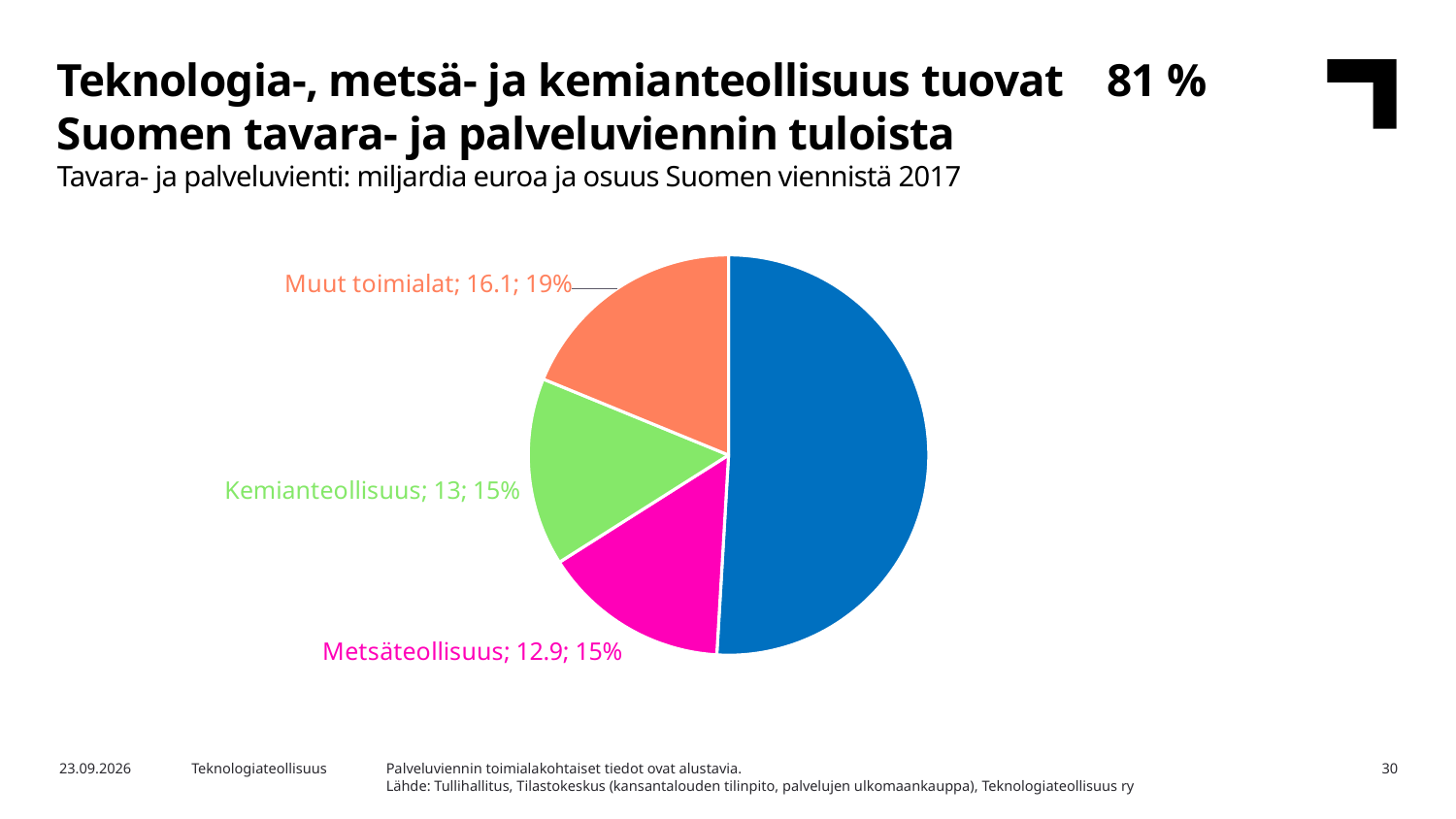
What share of the pie does Metsäteollisuus represent? 15% What value in billions of euros is shown for Kemianteollisuus? 13 What colour is the Kemianteollisuus slice? green What value in billions of euros is shown for Metsäteollisuus? 12.9 What is the difference in billions of euros between Muut toimialat and Kemianteollisuus? 3.1 How many slices does the pie chart have? 4 Which is larger, the value for Muut toimialat or the value for Metsäteollisuus? Muut toimialat What value in billions of euros is shown for Muut toimialat? 16.1 What share of the pie does Muut toimialat represent? 19% What kind of chart is shown on the slide? pie chart What share of the pie does Kemianteollisuus represent? 15% Among the labelled slices, which has the highest value? Muut toimialat